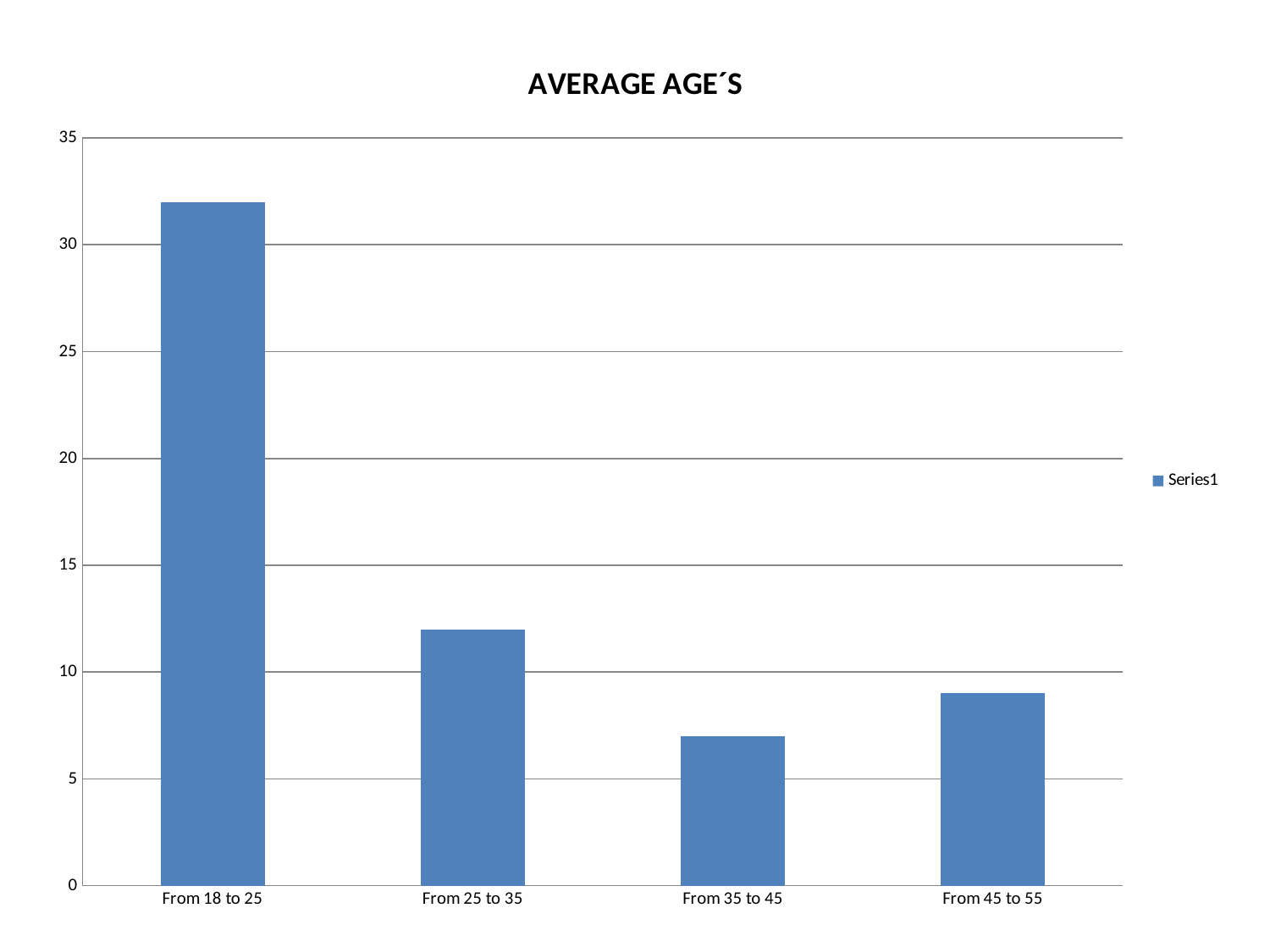
How many categories are shown on the x axis? 4 What is the title of the chart? AVERAGE AGE´S Which category has the highest value? From 18 to 25 Which category has the lowest value? From 35 to 45 How many series does the legend list? 1 Is the value for From 35 to 45 greater or less than 10? less Is the value for From 45 to 55 greater or less than 5? greater What type of chart is shown on the slide? Bar chart Which is larger, the value for From 35 to 45 or the value for From 45 to 55? From 45 to 55 Is the value for From 25 to 35 greater or less than 10? greater Which is larger, the value for From 25 to 35 or the value for From 45 to 55? From 25 to 35